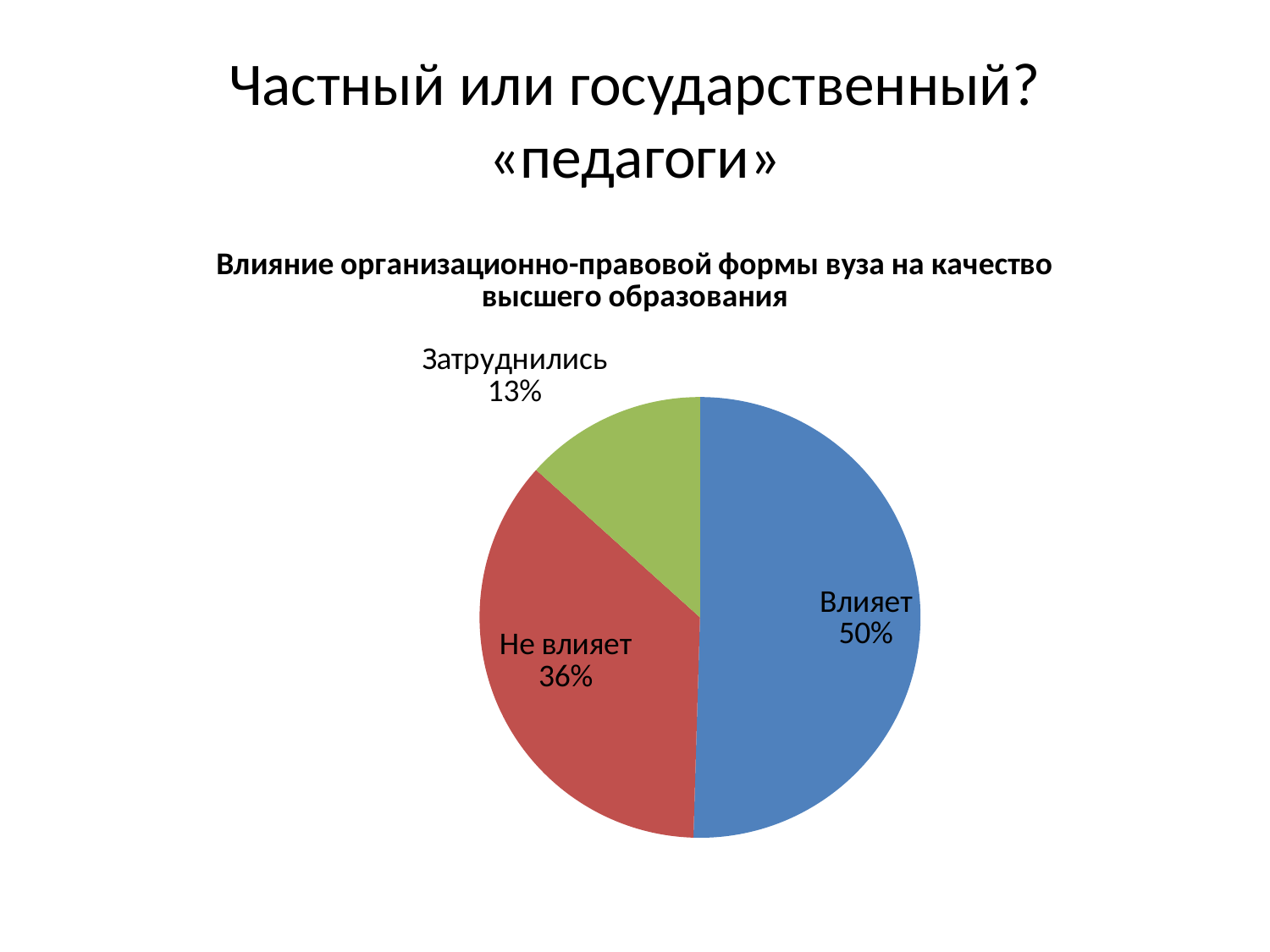
Which is larger, the value for "Не влияет" or the value for "Затруднились"? Не влияет Which category has the largest share of the pie? Влияет How many slices does the pie chart have? 3 What is the title of the chart? Влияние организационно-правовой формы вуза на качество высшего образования What colour is the slice for "Не влияет"? red What is the difference between the values for "Влияет" and "Не влияет"? 14% Which category has the smallest share of the pie? Затруднились What is the value for "Влияет"? 50% What type of chart is shown on the slide? pie chart What is the value for "Не влияет"? 36% What is the difference between the values for "Не влияет" and "Затруднились"? 23% What is the value for "Затруднились"? 13%